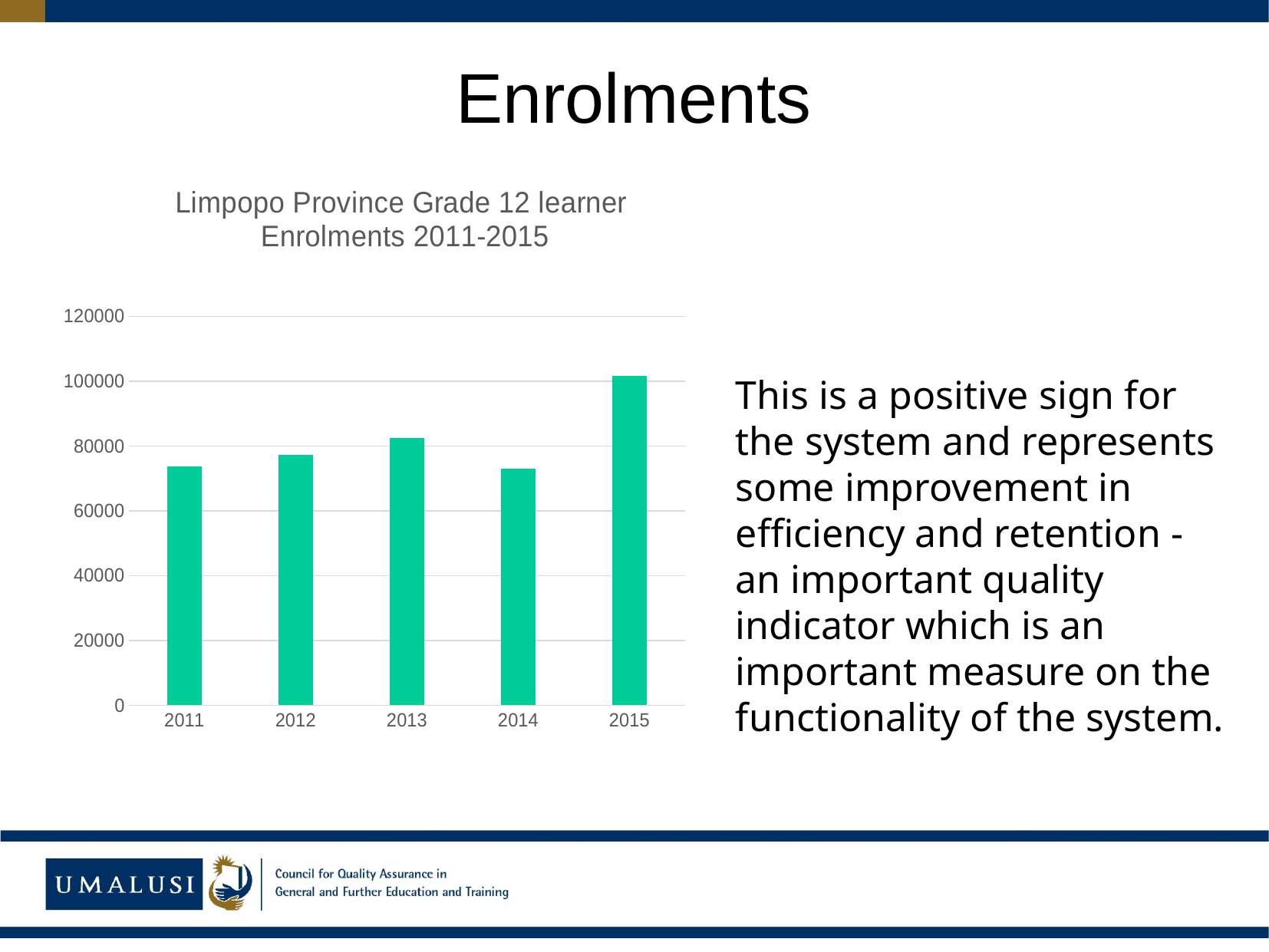
Which year has the highest enrolment? 2015 What is the title of the chart? Limpopo Province Grade 12 learner Enrolments 2011-2015 Which is larger, the enrolment for 2013 or for 2012? 2013 How many years are plotted on the chart? 5 Is the value for 2014 greater or less than 80000? less Is the value for 2015 greater or less than 100000? greater Is the value for 2013 greater or less than 80000? greater What type of chart is shown on the slide? bar chart Do enrolments rise or fall from 2014 to 2015? rise Which is larger, the enrolment for 2014 or for 2015? 2015